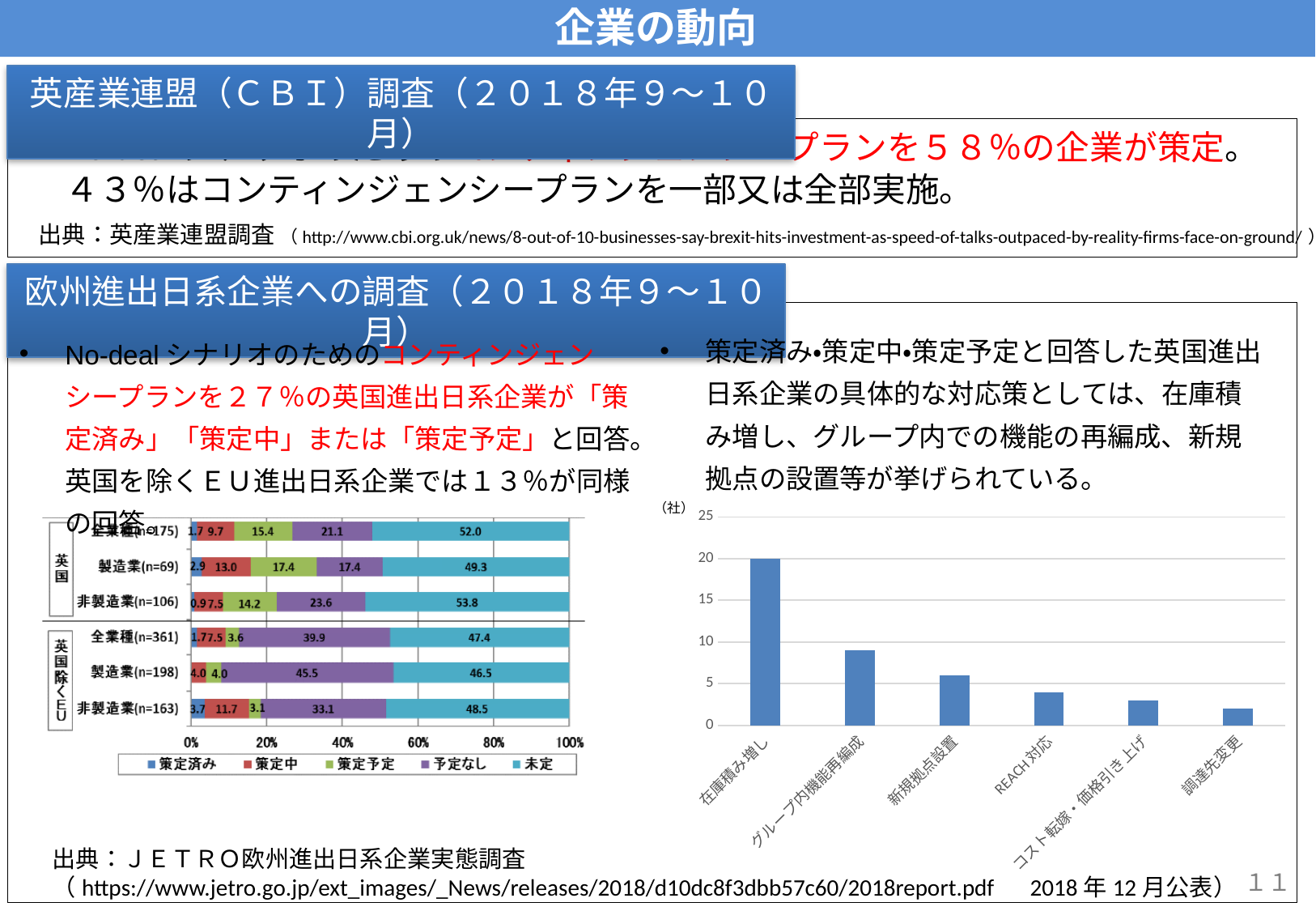
In the right bar chart, what is the value for 在庫積み増し? 20 In the left stacked bar chart, which category has the highest 策定予定 value? 英国 製造業(n=69) What kind of chart is the chart on the right of the slide? Bar chart How many categories are shown in the right bar chart? 6 In the right bar chart, which category has the lowest value? 調達先変更 In the left stacked bar chart, what is the 予定なし value for 英国除くEU 製造業(n=198)? 45.5 In the left stacked bar chart, what is the 策定中 value for 英国 製造業(n=69)? 13.0 In the left stacked bar chart, how many series does the legend list? 5 In the right bar chart, is the value for グループ内機能再編成 greater or less than 5? greater In the left stacked bar chart, what is the difference between the 未定 values for 英国 非製造業(n=106) and 英国 製造業(n=69)? 4.5 In the left stacked bar chart, what is the 未定 value for 英国 全業種(n=175)? 52.0 In the left stacked bar chart, which is larger: the 予定なし value for 英国 非製造業(n=106) or for 英国除くEU 非製造業(n=163)? 英国除くEU 非製造業(n=163)